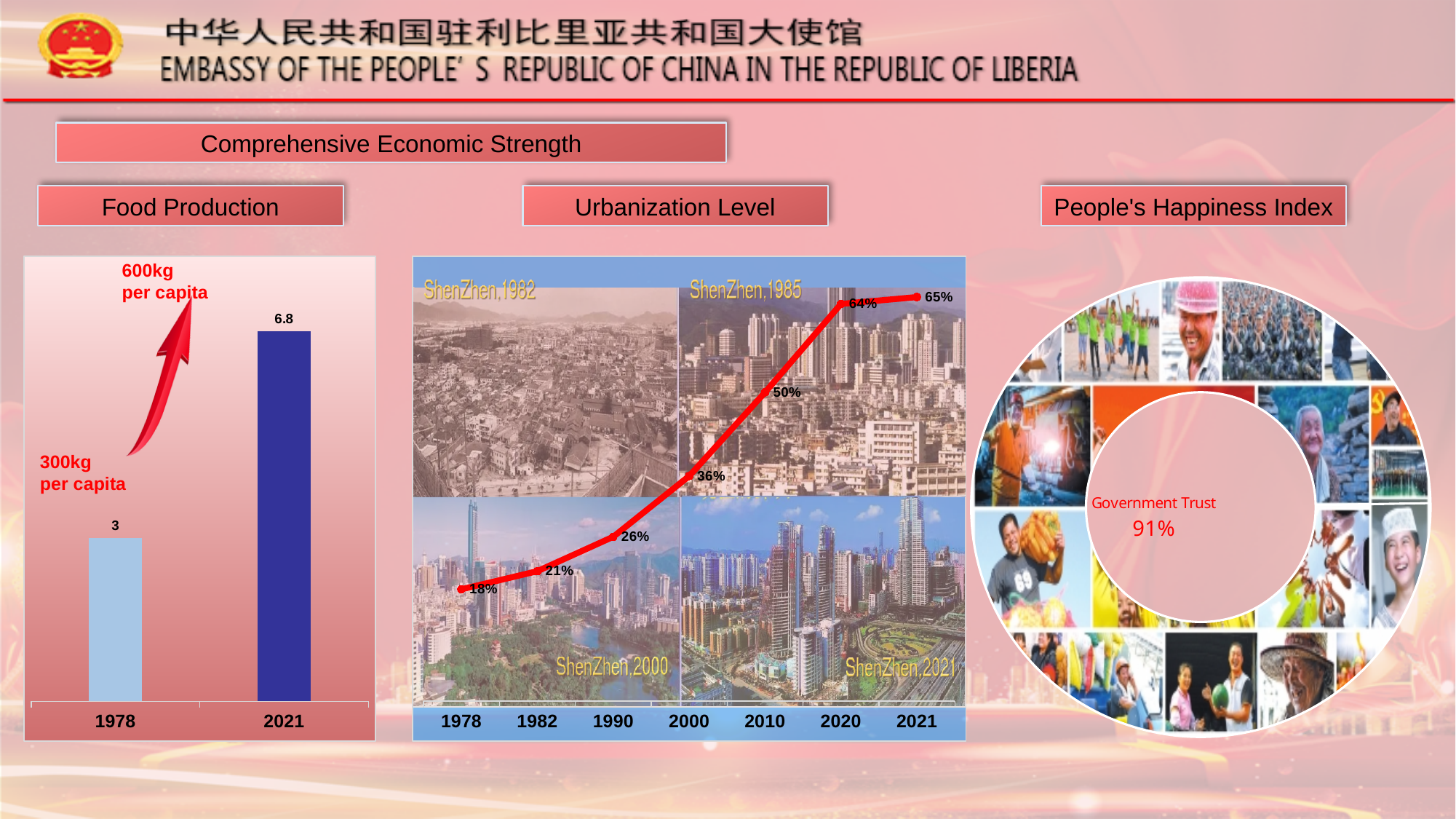
In the Urbanization Level chart, which year has the highest value? 2021 How many categories are shown on the x axis of the Food Production chart? 2 In the Food Production chart, what is the value for 1978? 3 In the Urbanization Level chart, what is the value for 1978? 18% What kind of chart is the Food Production chart? bar chart In the Urbanization Level chart, which year has the lowest value? 1978 How many data points are plotted in the Urbanization Level chart? 7 In the Food Production chart, what is the difference between the 2021 and 1978 values? 3.8 In the Urbanization Level chart, what is the difference between the 2020 and 2000 values? 28% In the Urbanization Level chart, do the values rise or fall from 1978 to 2021? rise In the Urbanization Level chart, what is the value for 2010? 50% In the Food Production chart, what is the value for 2021? 6.8